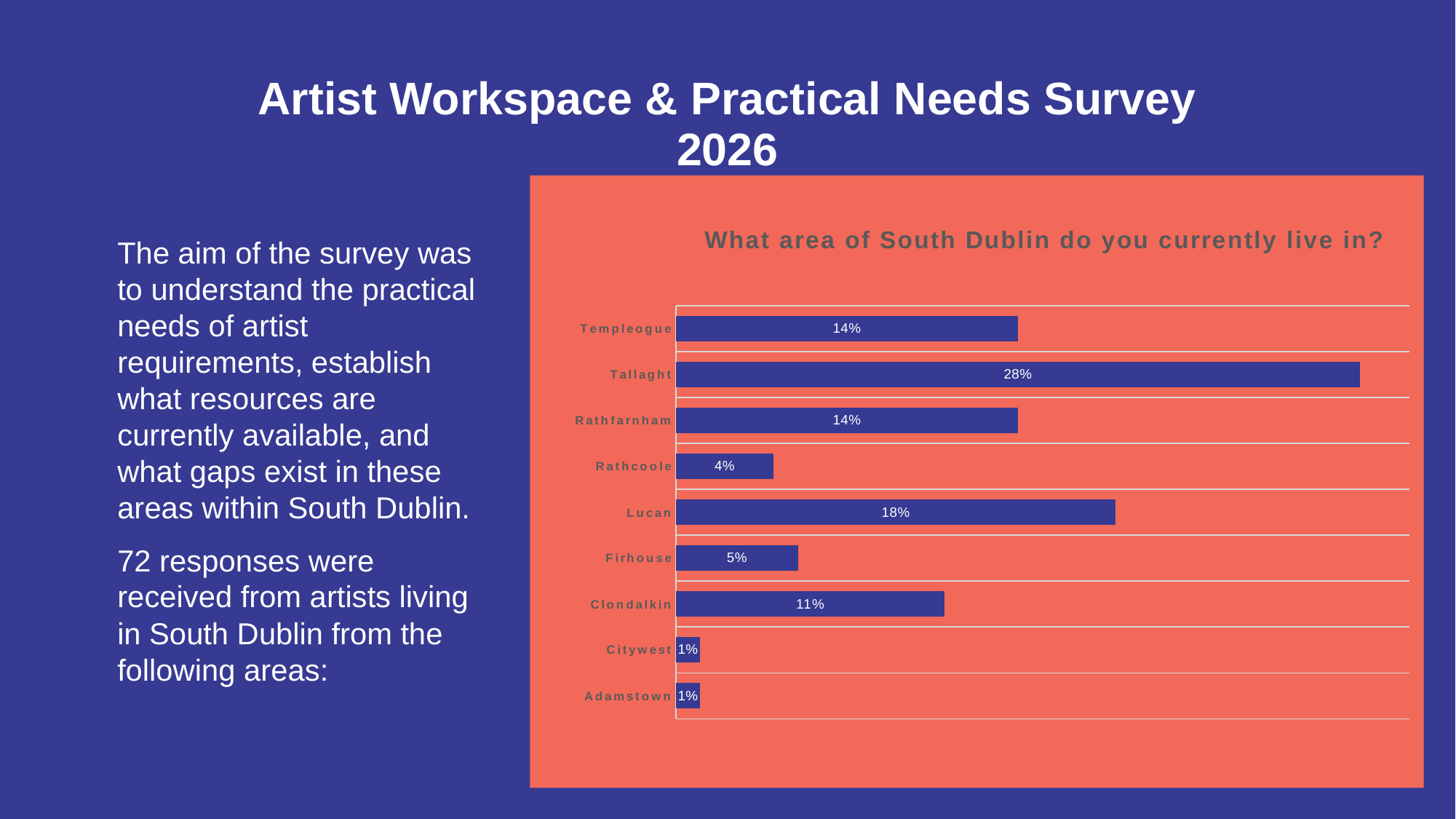
Which has a larger value, Clondalkin or Rathfarnham? Rathfarnham What is the title of the chart? What area of South Dublin do you currently live in? Which has a larger value, Lucan or Templeogue? Lucan What percentage of respondents live in Tallaght? 28% What is the difference between the values for Tallaght and Lucan? 10% What is the difference between the values for Templeogue and Firhouse? 9% What is the value shown for Clondalkin? 11% Which area has the highest percentage of respondents? Tallaght What is the value shown for Rathcoole? 4% How many areas are listed on the chart? 9 What percentage of respondents live in Lucan? 18% What type of chart is shown on the slide? Bar chart